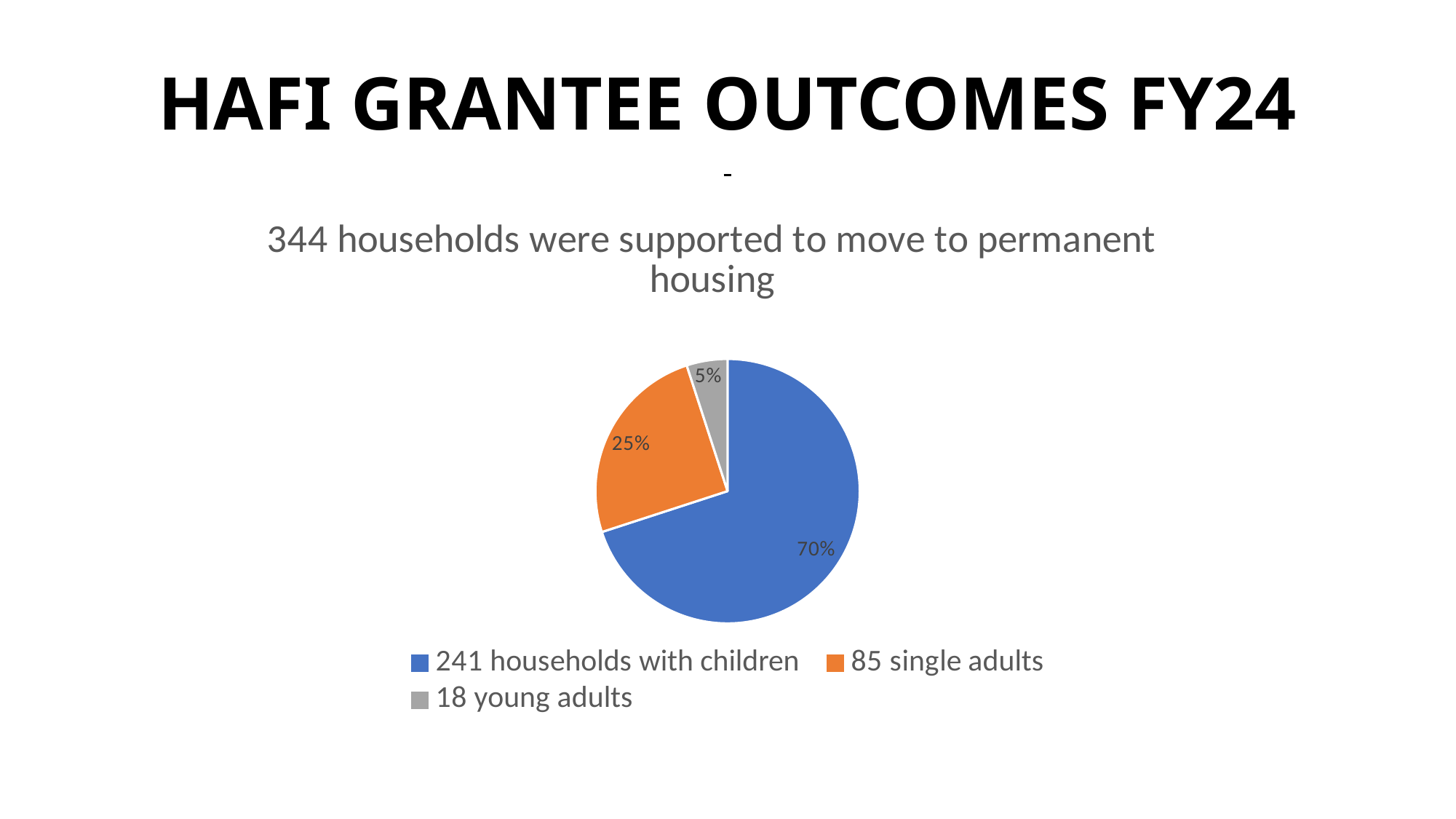
How many entries does the legend list? 3 Which category has the largest slice of the pie? 241 households with children What kind of chart is shown on the slide? pie chart How many slices does the pie chart have? 3 What is the title of the chart? 344 households were supported to move to permanent housing What colour is the slice for single adults? orange What percentage of the pie is labelled for households with children? 70% What is the difference in percentage points between the households with children slice and the single adults slice? 45 Which slice is larger, single adults or young adults? single adults What percentage of the pie is labelled for single adults? 25% What percentage of the pie is labelled for young adults? 5% Which category has the smallest slice of the pie? 18 young adults